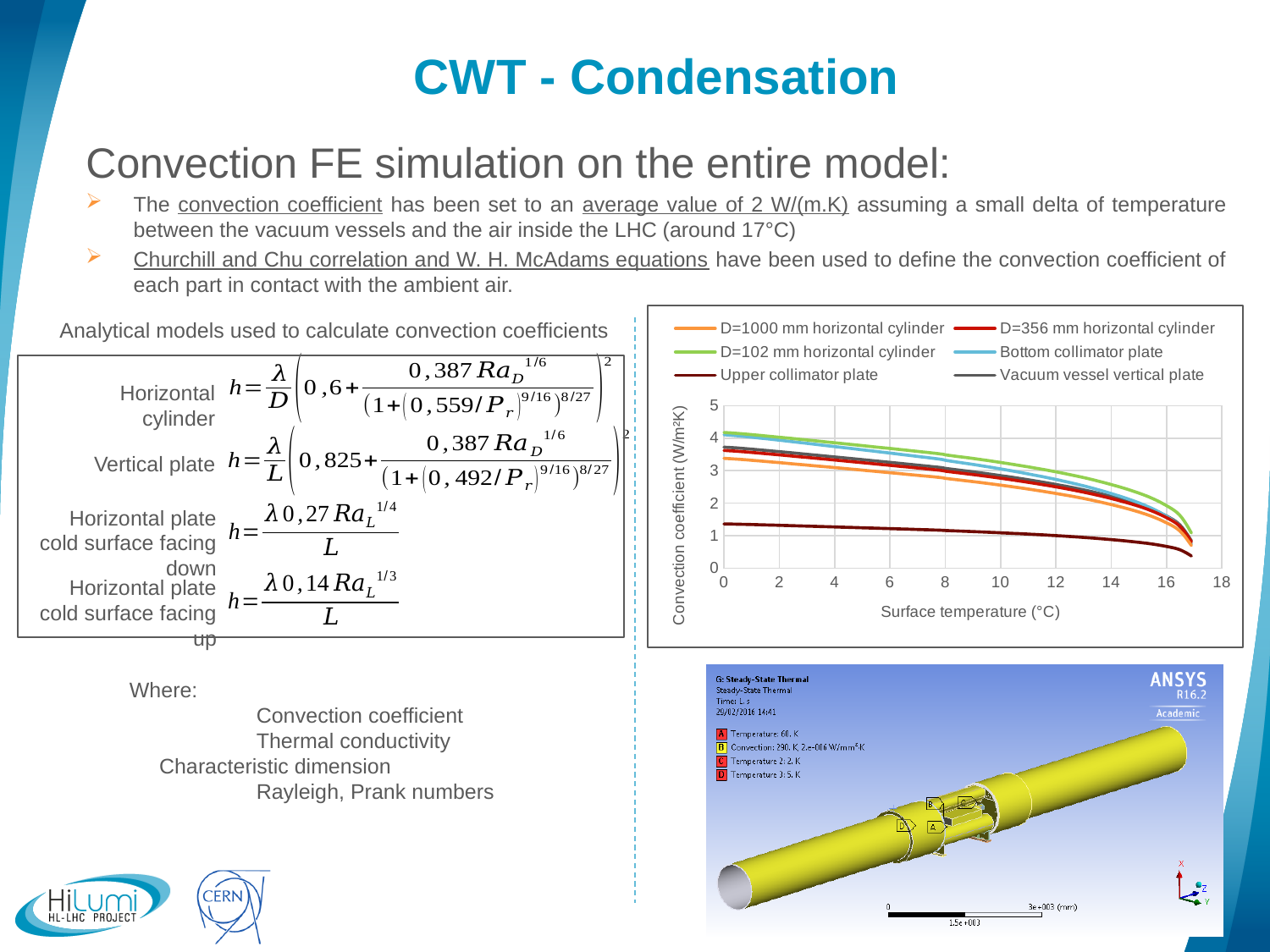
Which series has the highest convection coefficient across the whole temperature range? D=102 mm horizontal cylinder Which series has the lowest convection coefficient across the whole temperature range? Upper collimator plate What kind of chart is shown on the slide? line chart What is the label of the chart's x axis? Surface temperature (°C) What is the label of the chart's y axis? Convection coefficient (W/m²K) Do the convection coefficient values rise or fall as surface temperature increases? fall Is the convection coefficient for the Upper collimator plate at 0 °C greater or less than 2? less At a surface temperature of 8 °C, which has the larger convection coefficient: the D=1000 mm horizontal cylinder or the D=102 mm horizontal cylinder? D=102 mm horizontal cylinder At a surface temperature of 0 °C, which has the larger convection coefficient: the Upper collimator plate or the Vacuum vessel vertical plate? Vacuum vessel vertical plate Is the convection coefficient for the Bottom collimator plate at 0 °C greater or less than 3? greater How many series does the chart's legend list? 6 Is the convection coefficient for the D=102 mm horizontal cylinder at 0 °C greater or less than 3? greater